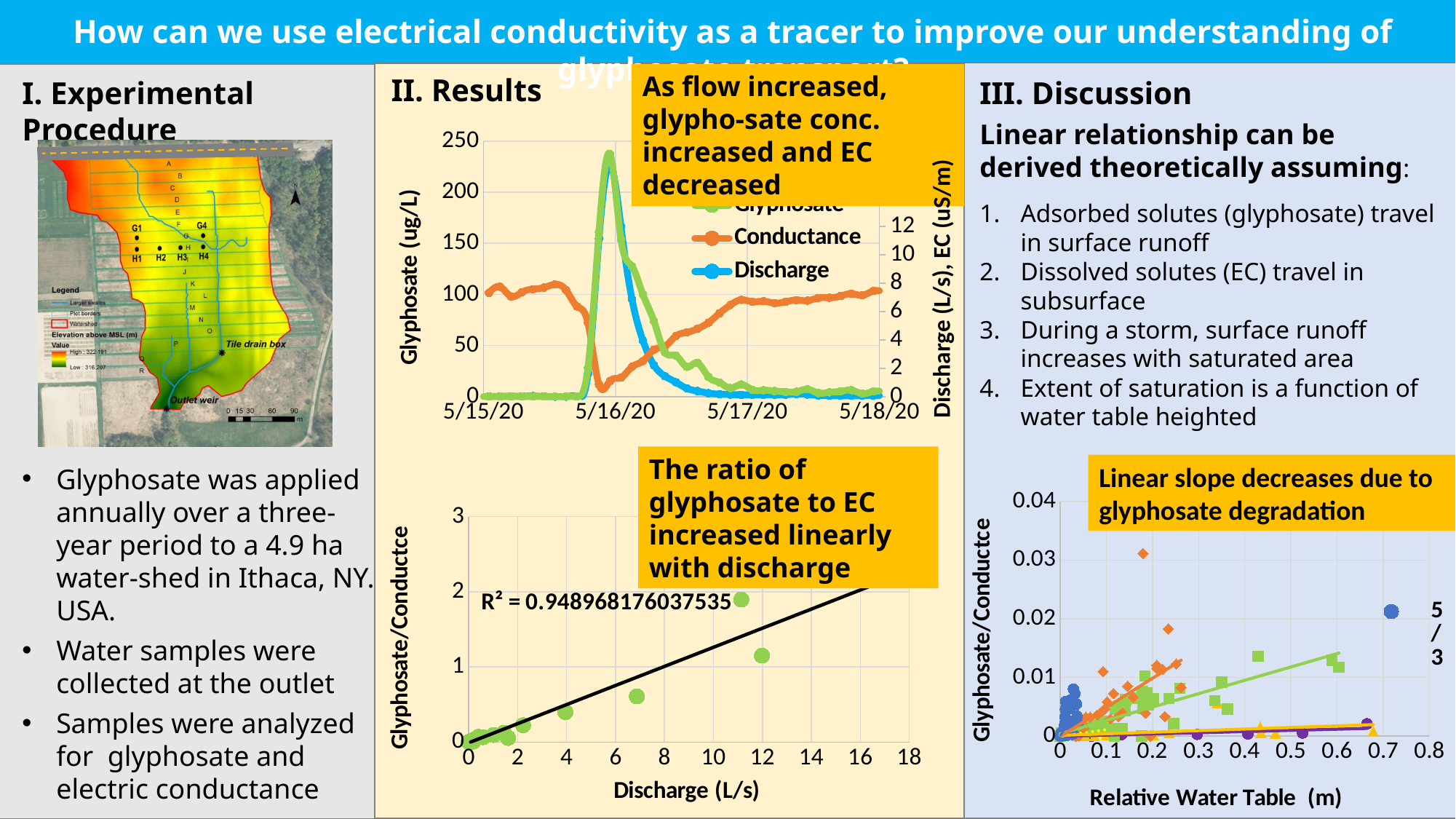
In the top chart in the Results section, what are the three series named in the legend? Glyphosate, Conductance, Discharge What kind of chart is the top chart in the Results section? line chart In the top chart in the Results section, what is the label of the left vertical axis? Glyphosate (ug/L) In the bottom chart in the Results section, is the highest plotted Glyphosate/Conductance value greater or less than 1? greater In the bottom chart in the Results section, what is the label of the x axis? Discharge (L/s) In the top chart in the Results section, is the peak Glyphosate value greater or less than 200? greater In the chart in the Discussion section, what is the maximum value shown on the vertical axis? 0.04 In the bottom chart in the Results section, do the Glyphosate/Conductance values rise or fall as Discharge increases? rise In the top chart in the Results section, how many series does the legend list? 3 In the top chart in the Results section, what is the first date shown on the x axis? 5/15/20 In the bottom chart in the Results section (Glyphosate/Conductance vs Discharge), what R² value is printed? R² = 0.948968176037535 In the chart in the Discussion section, what is the label of the x axis? Relative Water Table (m)